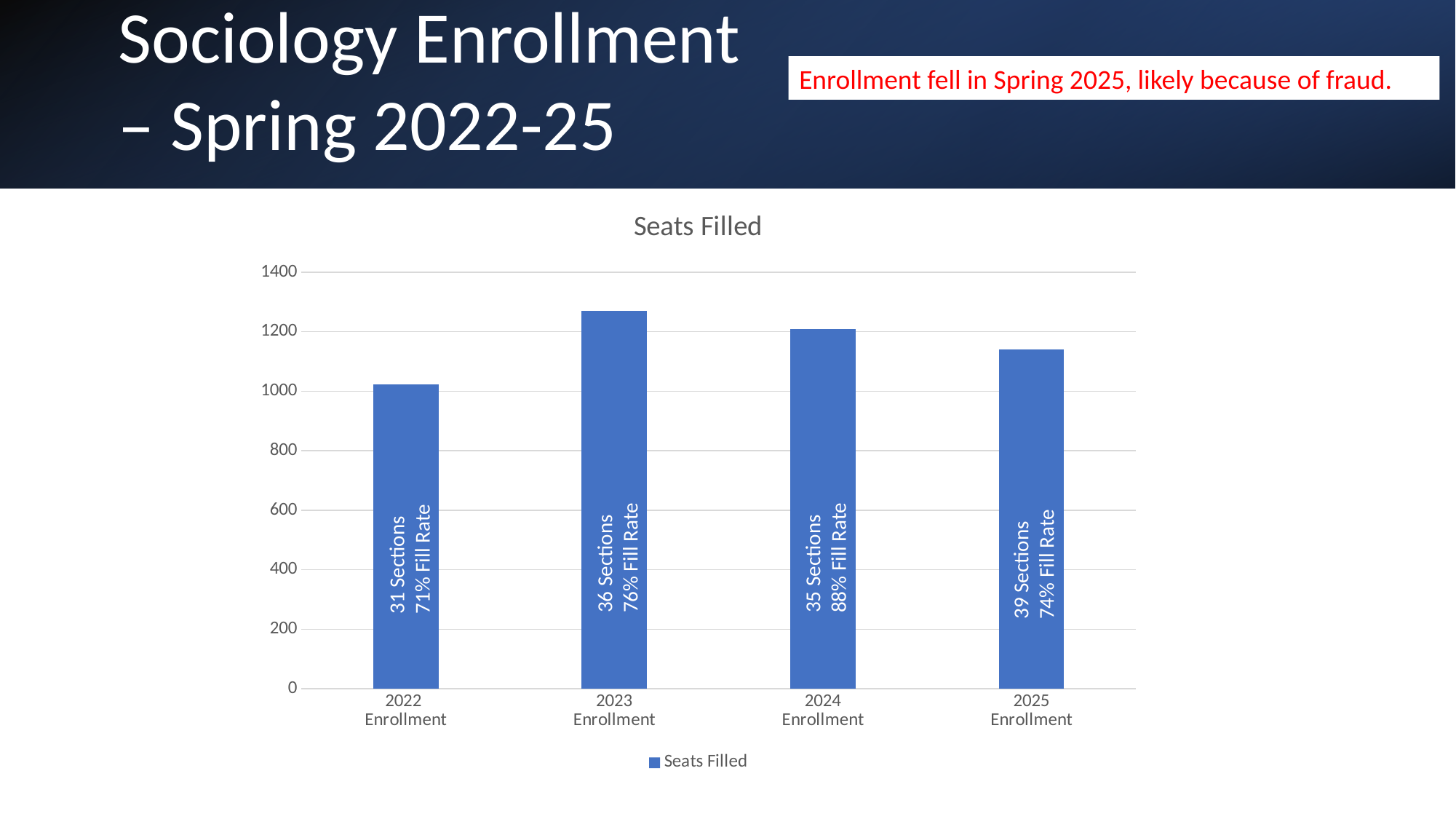
Which year has the lowest number of seats filled? 2022 How many sections were offered in 2025 according to the bar label? 39 Sections Which is larger, seats filled in 2024 or in 2025? 2024 How many years (categories) are plotted in the Seats Filled chart? 4 Is the value for 2023 Enrollment greater or less than 1200? greater Is the value for 2025 Enrollment greater or less than 1000? greater What kind of chart is shown on the slide? bar chart Which year has the highest number of seats filled? 2023 How many series does the legend list? 1 Is the value for 2022 Enrollment greater or less than 1200? less Do seats filled rise or fall from 2023 to 2025? fall What fill rate is shown on the 2024 bar? 88% Fill Rate